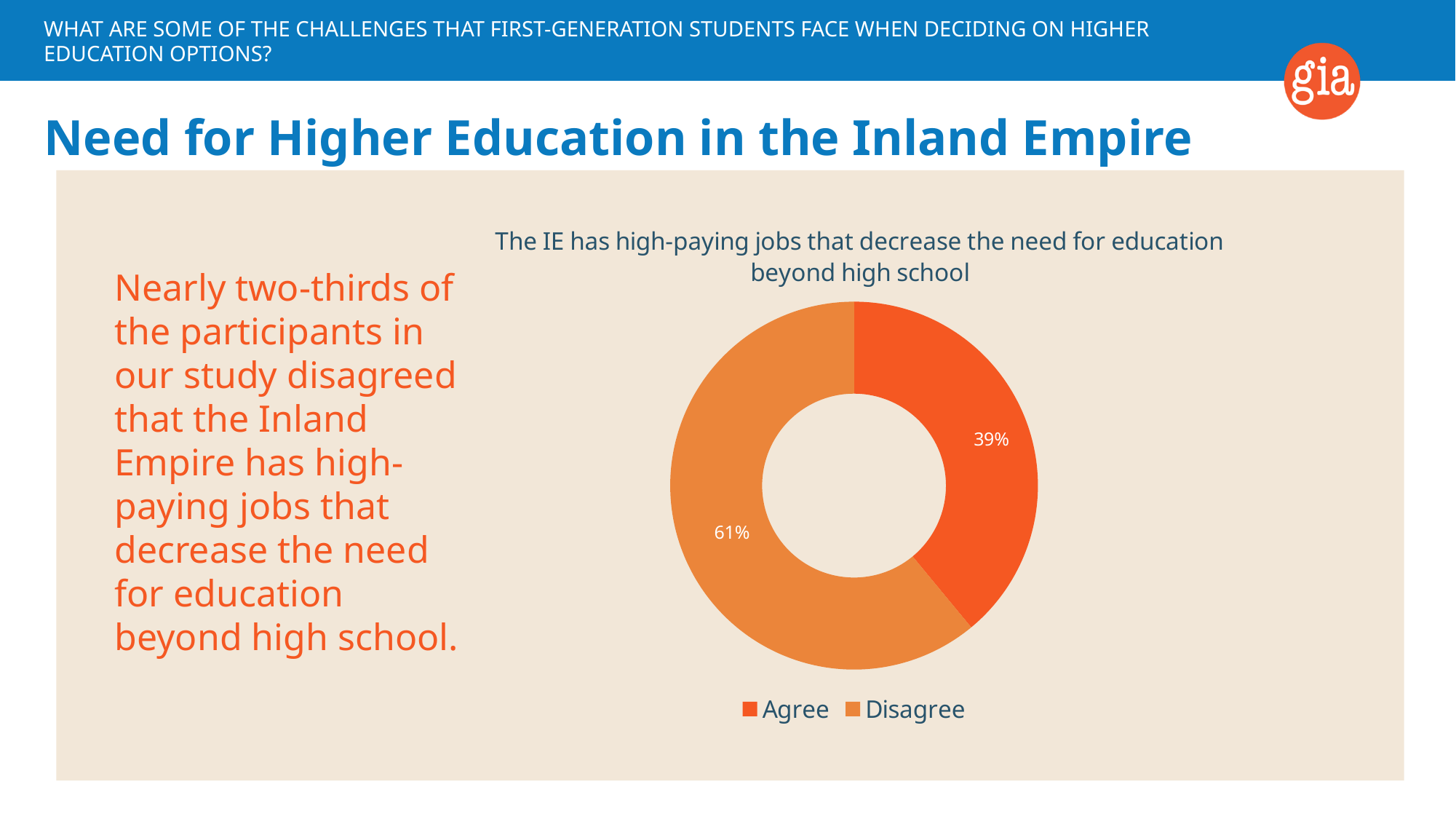
Which response has the larger share of the chart, Agree or Disagree? Disagree What percentage of participants agreed that the IE has high-paying jobs that decrease the need for education beyond high school? 39% What are the two legend entries of the chart? Agree and Disagree What is the title of the chart? The IE has high-paying jobs that decrease the need for education beyond high school How many categories are shown in the chart? 2 What is the difference in percentage points between the Disagree and Agree shares? 22 What kind of chart is shown on the slide? Doughnut (pie) chart Is the share for Agree larger or smaller than the share for Disagree? smaller What share of the chart does the Disagree slice represent? 61% What percentage of participants disagreed that the IE has high-paying jobs that decrease the need for education beyond high school? 61% Which response has the smaller share of the chart? Agree